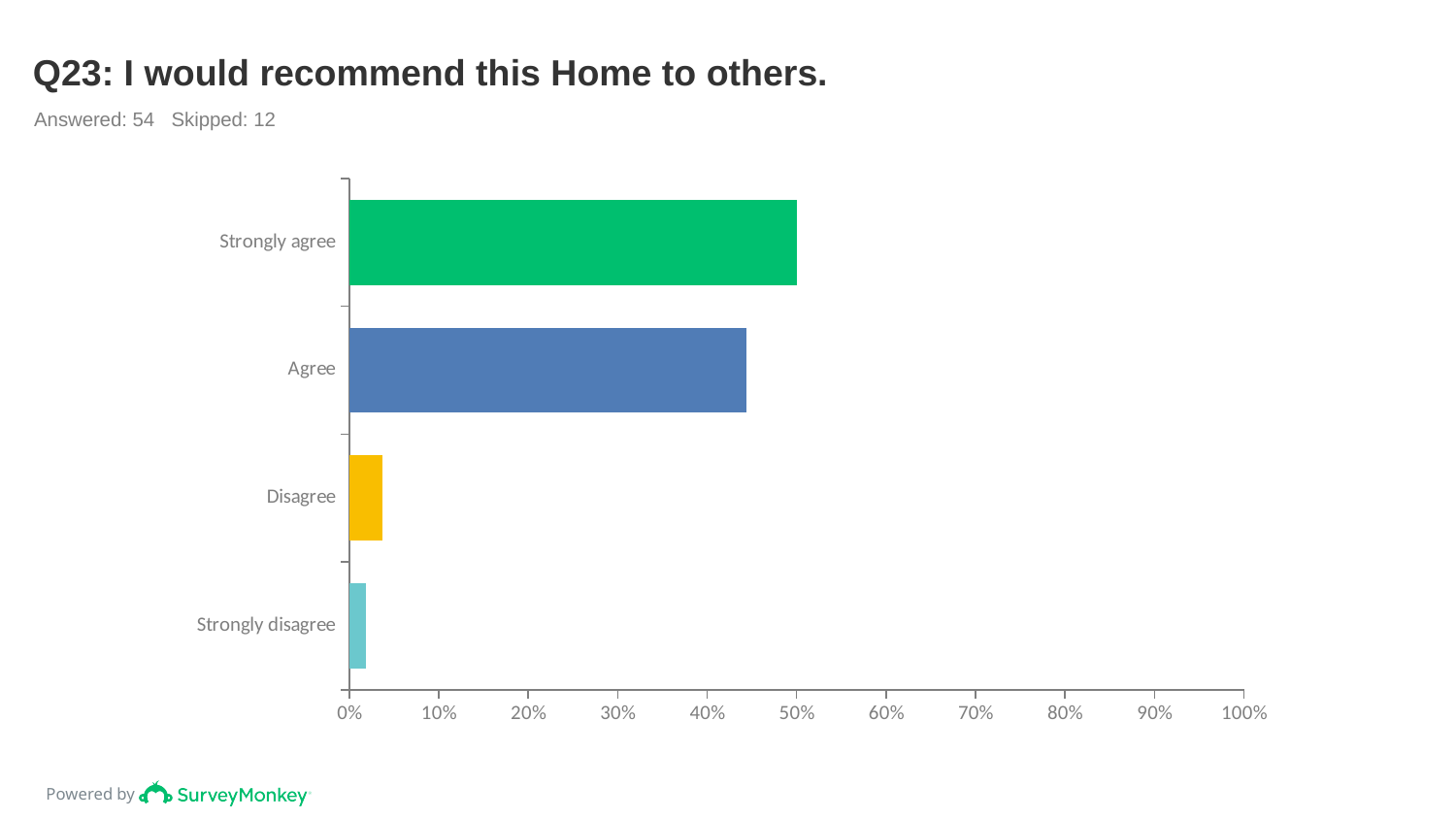
Is the value for Agree greater or less than 40%? greater What is the value for Strongly agree? 50% What kind of chart is shown on the slide? bar chart How many respondents answered this question according to the slide? 54 How many categories are shown in the chart? 4 What is the title of the chart? Q23: I would recommend this Home to others. Is the value for Disagree greater or less than 10%? less Which is larger, the value for Agree or the value for Disagree? Agree Is the value for Strongly disagree greater or less than 10%? less Which category has the lowest value? Strongly disagree Which category has the highest value? Strongly agree Which is larger, the value for Disagree or the value for Strongly disagree? Disagree